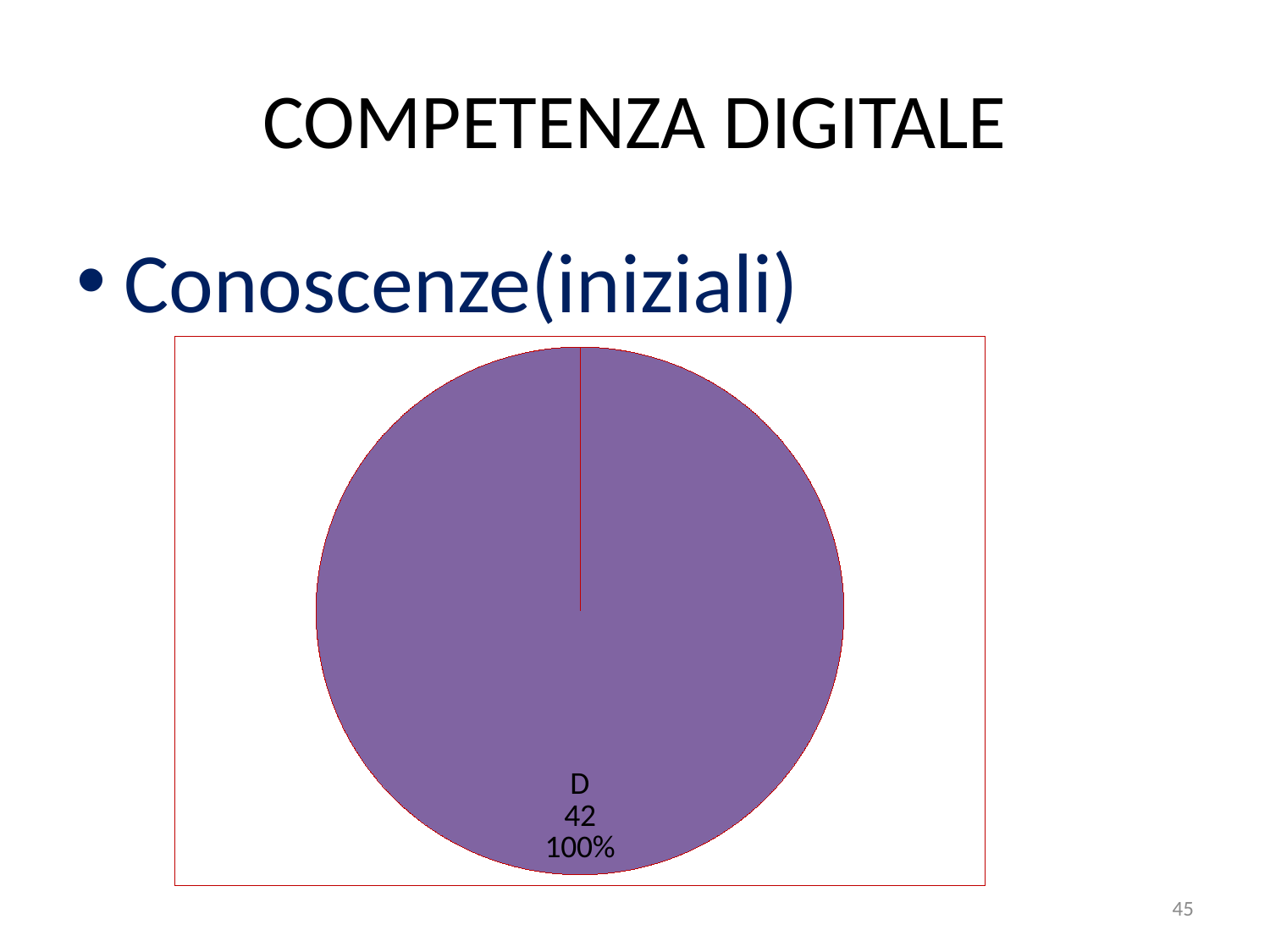
Which category is the largest slice in the pie chart? D How many slices does the pie chart have? 1 What colour is the slice in the pie chart? purple What is the value shown for category D in the pie chart? 42 What share of the pie does category D represent? 100% What is the label of the only slice in the pie chart? D What kind of chart is shown on the slide? pie chart